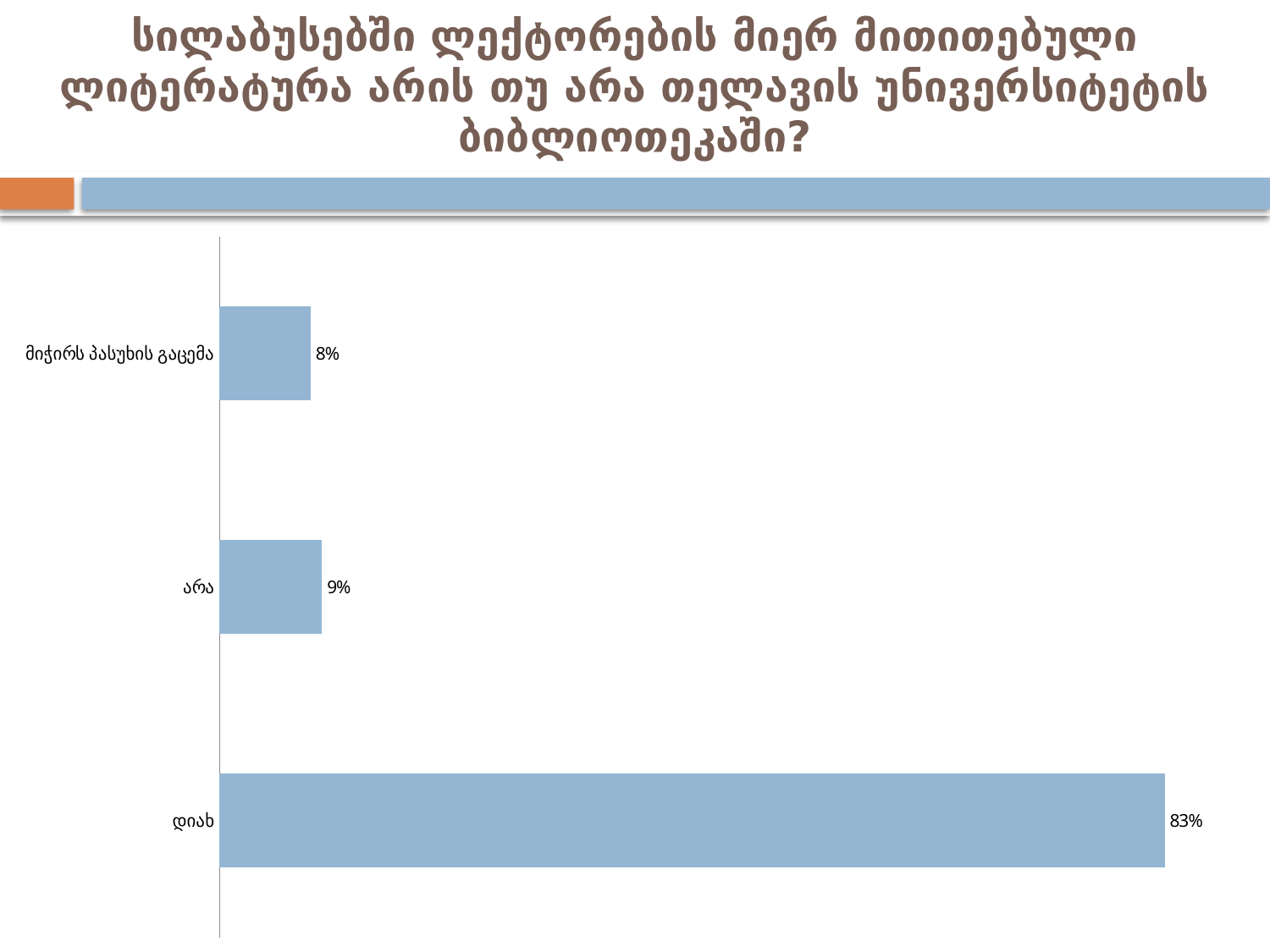
What is the value for დიახ? 83% What is the difference between the values for დიახ and არა? 74% What kind of chart is shown on the slide? bar chart Which is larger, the value for დიახ or the value for მიჭირს პასუხის გაცემა? დიახ Which category has the highest value? დიახ How many categories are shown in the chart? 3 What is the difference between the values for არა and მიჭირს პასუხის გაცემა? 1% What is the value for მიჭირს პასუხის გაცემა? 8% What colour are the bars in the chart? light blue Are the bars in the chart horizontal or vertical? horizontal What is the value for არა? 9% Which category has the lowest value? მიჭირს პასუხის გაცემა